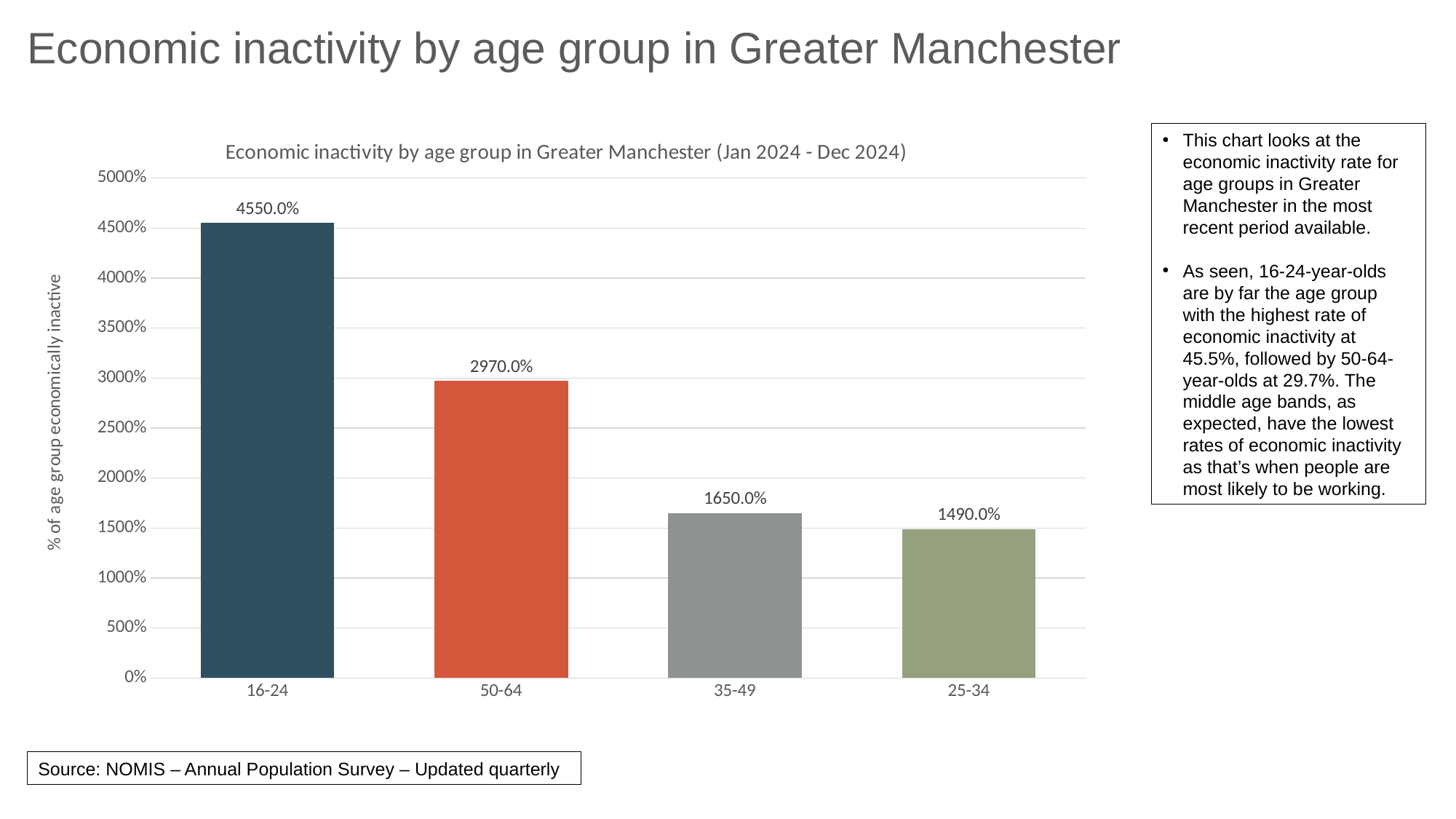
What is the value shown for the 25-34 age group? 1490.0% What is the value shown for the 50-64 age group? 2970.0% What is the difference between the values for 35-49 and 25-34? 160.0% How many age groups are shown on the chart? 4 Which has a larger value, 50-64 or 35-49? 50-64 What is the difference between the values for 16-24 and 50-64? 1580.0% What is the value shown for the 35-49 age group? 1650.0% What kind of chart is shown on the slide? Bar chart What is the label on the vertical axis of the chart? % of age group economically inactive What is the value shown for the 16-24 age group? 4550.0% Which age group has the lowest value on the chart? 25-34 Which age group has the highest value on the chart? 16-24